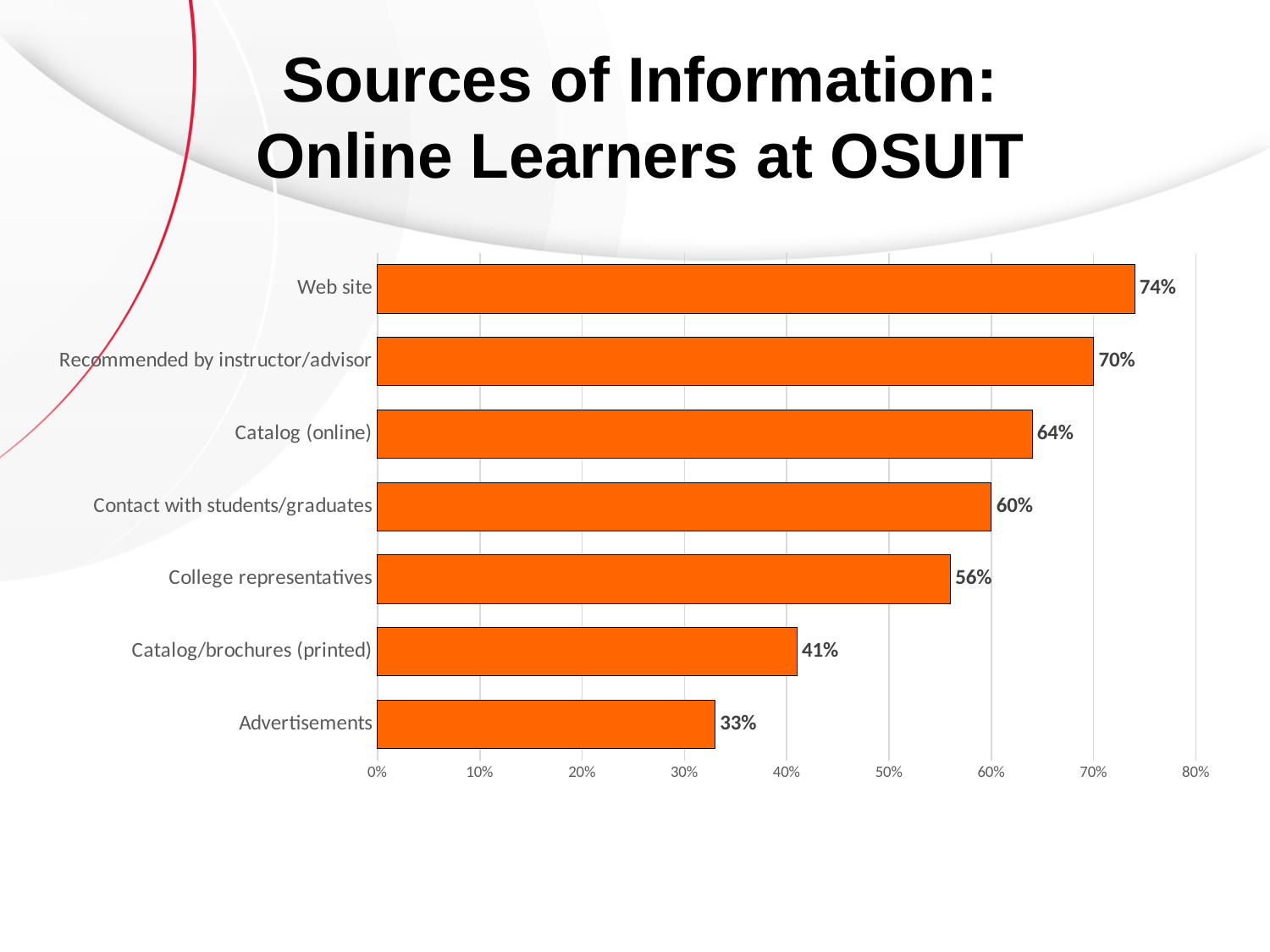
What is the value for Catalog/brochures (printed)? 41% Which source of information has the highest value? Web site What is the value for Contact with students/graduates? 60% Which is larger, the value for College representatives or the value for Catalog/brochures (printed)? College representatives Is the value for Catalog (online) greater or less than 50%? greater What kind of chart is shown on the slide? bar chart What is the value for Web site? 74% How many sources of information are shown in the chart? 7 What is the title of the slide? Sources of Information: Online Learners at OSUIT Which source of information has the lowest value? Advertisements What is the difference between the values for Web site and Advertisements? 41% What is the difference between the values for Recommended by instructor/advisor and Catalog (online)? 6%